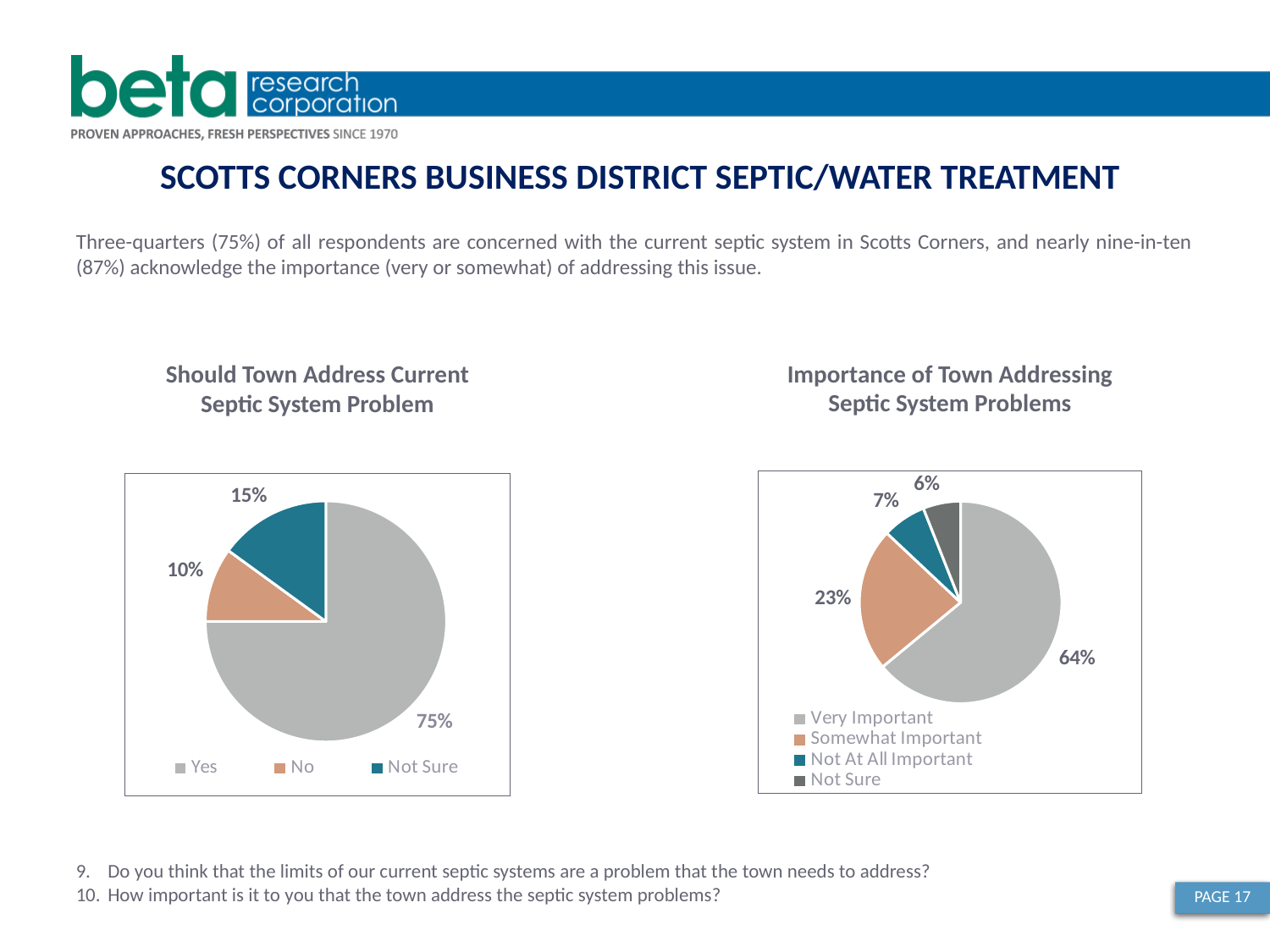
In the 'Importance of Town Addressing Septic System Problems' chart, how many slices does the pie have? 4 In the 'Importance of Town Addressing Septic System Problems' chart, what is the combined share of Very Important and Somewhat Important? 87% In the 'Importance of Town Addressing Septic System Problems' chart, which is larger: Somewhat Important or Not Sure? Somewhat Important In the 'Importance of Town Addressing Septic System Problems' chart, what percentage said Very Important? 64% In the 'Should Town Address Current Septic System Problem' chart, what percentage of respondents answered Yes? 75% In the 'Importance of Town Addressing Septic System Problems' chart, which category has the largest share? Very Important In the 'Should Town Address Current Septic System Problem' chart, what percentage answered Not Sure? 15% What type of chart is used for 'Should Town Address Current Septic System Problem'? Pie chart In the 'Should Town Address Current Septic System Problem' chart, which response has the smallest share? No In the 'Should Town Address Current Septic System Problem' chart, how many entries does the legend list? 3 In the 'Should Town Address Current Septic System Problem' chart, what is the difference between the Yes and No shares? 65% In the 'Importance of Town Addressing Septic System Problems' chart, what percentage said Not At All Important? 7%